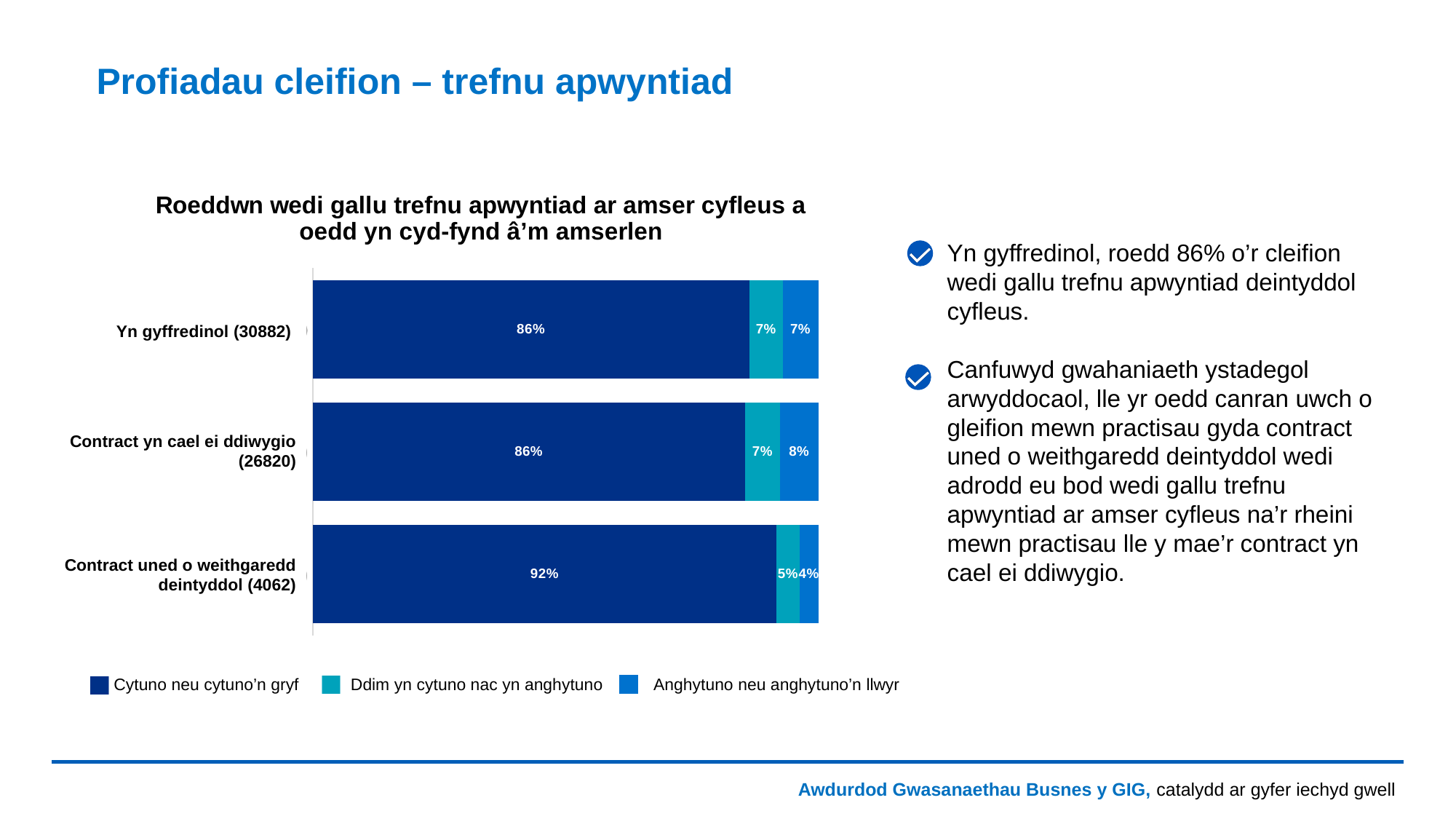
What is the 'Anghytuno neu anghytuno'n llwyr' value for 'Contract yn cael ei ddiwygio (26820)'? 8% How many categories are shown on the chart? 3 What is the total of the three segments for the 'Contract uned o weithgaredd deintyddol (4062)' bar? 101% What is the 'Ddim yn cytuno nac yn anghytuno' value for 'Yn gyffredinol (30882)'? 7% What percentage of patients in the 'Contract uned o weithgaredd deintyddol (4062)' group answered 'Cytuno neu cytuno'n gryf'? 92% What type of chart is shown on the slide? Stacked bar chart How many series does the legend list? 3 Which is larger: the 'Anghytuno neu anghytuno'n llwyr' value for 'Contract yn cael ei ddiwygio (26820)' or for 'Contract uned o weithgaredd deintyddol (4062)'? Contract yn cael ei ddiwygio (26820) Which category has the highest 'Cytuno neu cytuno'n gryf' percentage? Contract uned o weithgaredd deintyddol (4062) What is the difference in the 'Cytuno neu cytuno'n gryf' percentage between 'Contract uned o weithgaredd deintyddol (4062)' and 'Yn gyffredinol (30882)'? 6 percentage points Which category has the lowest 'Anghytuno neu anghytuno'n llwyr' percentage? Contract uned o weithgaredd deintyddol (4062) Which legend entry is shown in the darkest blue colour? Cytuno neu cytuno'n gryf